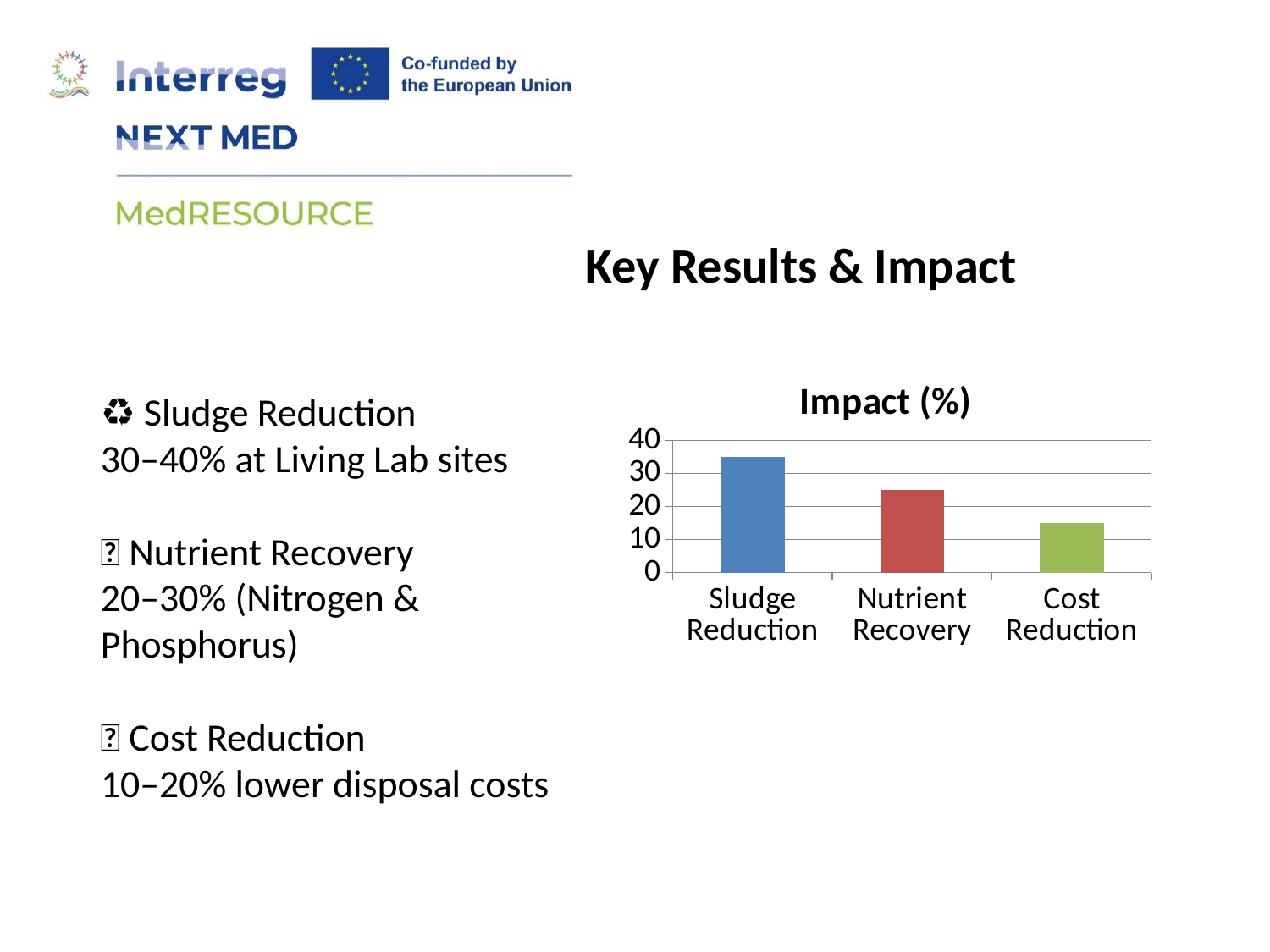
Which is larger, the value for Nutrient Recovery or the value for Cost Reduction? Nutrient Recovery What colour is the bar for Sludge Reduction? blue Which is larger, the value for Sludge Reduction or the value for Nutrient Recovery? Sludge Reduction How many categories are plotted in the chart? 3 Is the value for Nutrient Recovery greater or less than 20? greater Is the value for Cost Reduction greater or less than 20? less Which category has the highest value in the chart? Sludge Reduction Is the value for Sludge Reduction greater or less than 30? greater Do the values rise or fall from left to right across the categories? fall What is the title of the chart? Impact (%) Which category has the lowest value in the chart? Cost Reduction What kind of chart is shown on the slide? bar chart